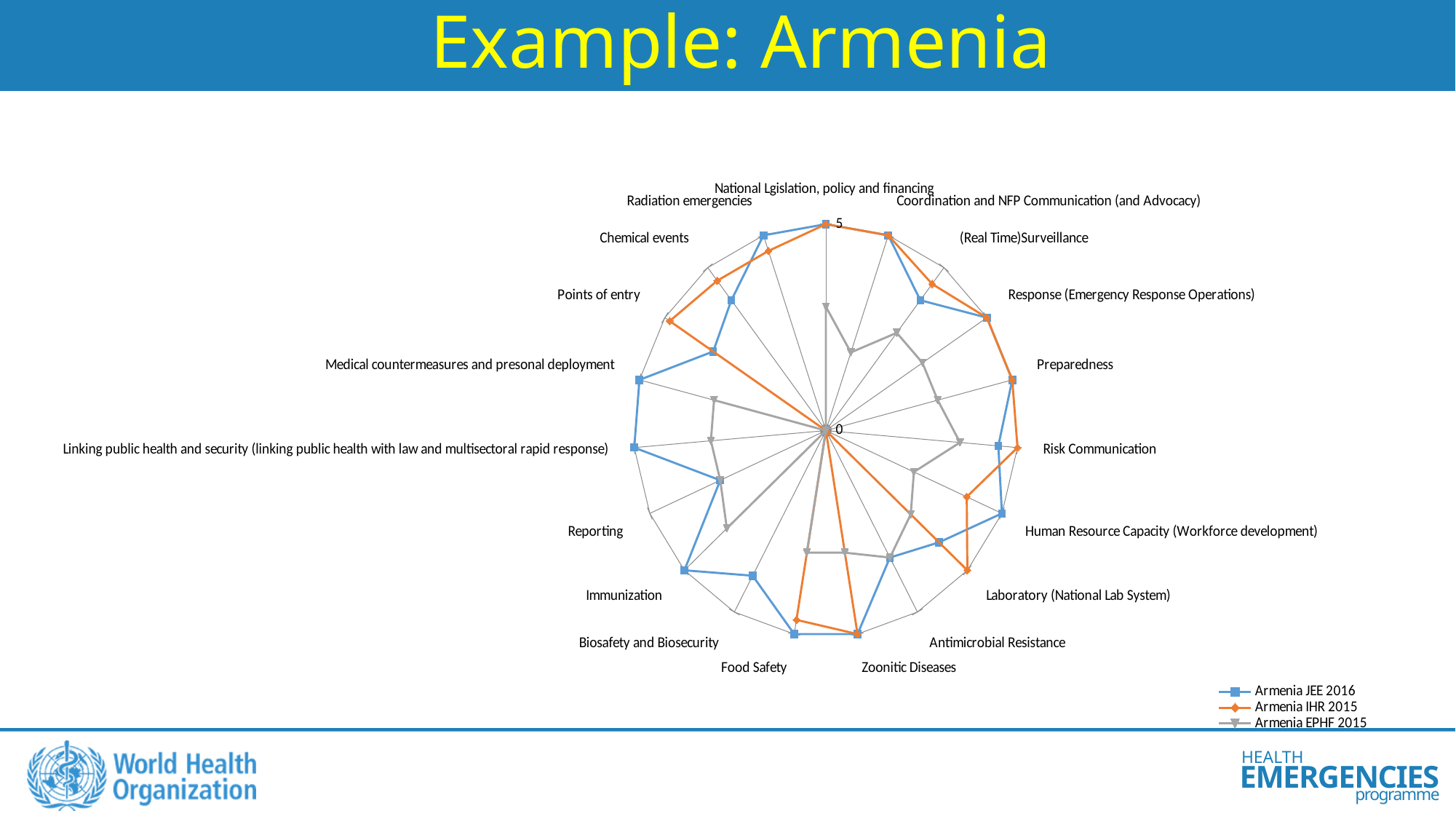
What kind of chart is shown on the slide? Radar chart For Points of entry, which series has the larger value: Armenia JEE 2016 or Armenia IHR 2015? Armenia IHR 2015 For Medical countermeasures and personal deployment, which series has the larger value: Armenia JEE 2016 or Armenia IHR 2015? Armenia JEE 2016 Which series is shown with the grey line and triangle markers? Armenia EPHF 2015 For Linking public health and security, which series has the larger value: Armenia JEE 2016 or Armenia IHR 2015? Armenia JEE 2016 Which series is shown with the orange line and diamond markers? Armenia IHR 2015 How many series does the legend list? 3 What is the maximum value shown on the radar chart's axis scale? 5 How many categories (axes) does the radar chart have? 19